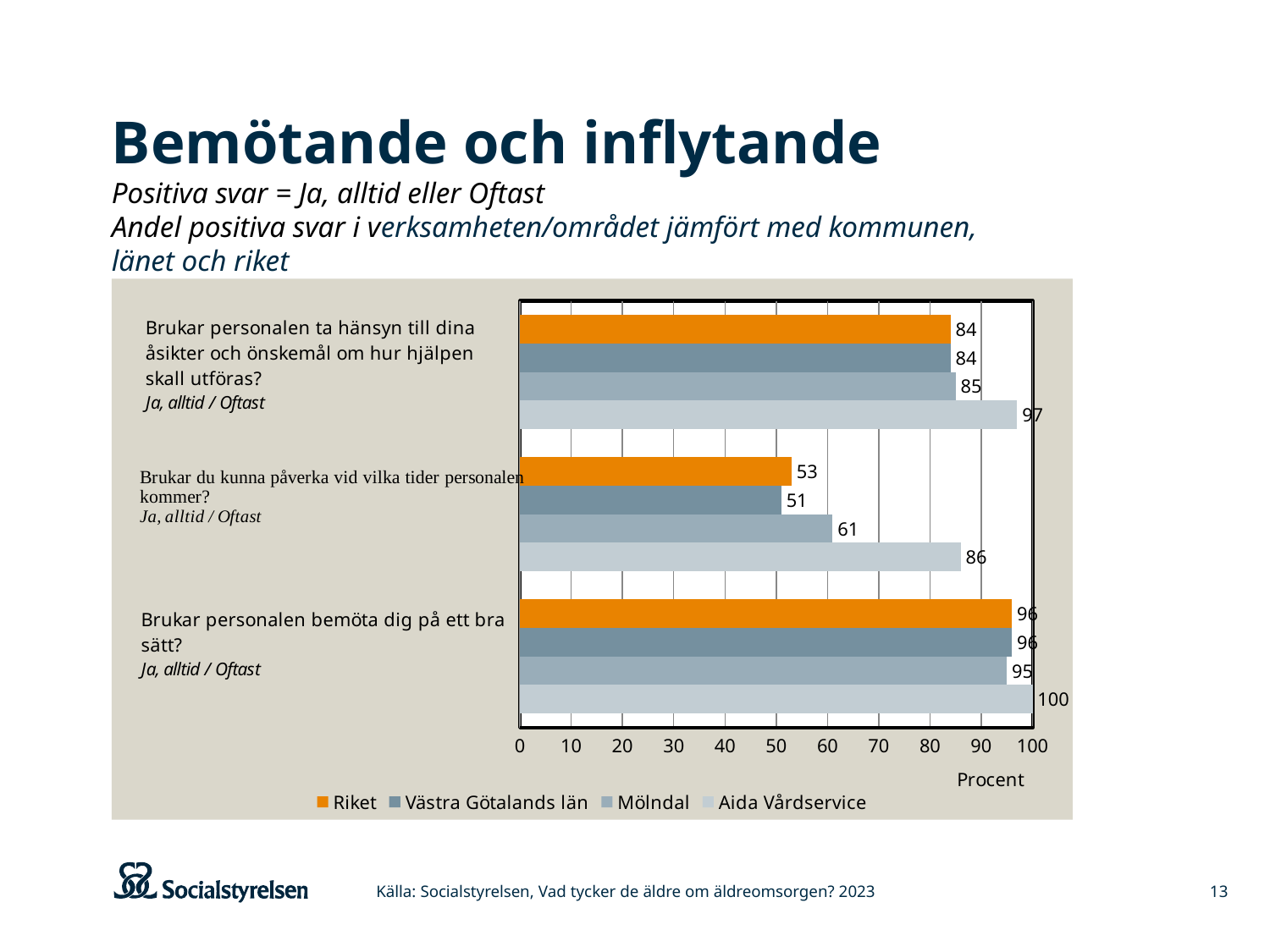
What is the value for Aida Vårdservice for "Brukar du kunna påverka vid vilka tider personalen kommer?"? 86 What is the value for Riket for "Brukar personalen ta hänsyn till dina åsikter och önskemål om hur hjälpen skall utföras?"? 84 What is the difference between Aida Vårdservice and Riket for "Brukar du kunna påverka vid vilka tider personalen kommer?"? 33 How many question categories are plotted in the chart? 3 Which series has the highest value for "Brukar du kunna påverka vid vilka tider personalen kommer?"? Aida Vårdservice Which is larger for "Brukar personalen ta hänsyn till dina åsikter och önskemål om hur hjälpen skall utföras?": Mölndal or Aida Vårdservice? Aida Vårdservice What kind of chart is shown on the slide? bar chart Which series has the lowest value for "Brukar du kunna påverka vid vilka tider personalen kommer?"? Västra Götalands län How many series does the legend list? 4 What is the label on the horizontal axis of the chart? Procent What is the value for Aida Vårdservice for "Brukar personalen bemöta dig på ett bra sätt?"? 100 What is the value for Mölndal for "Brukar personalen bemöta dig på ett bra sätt?"? 95